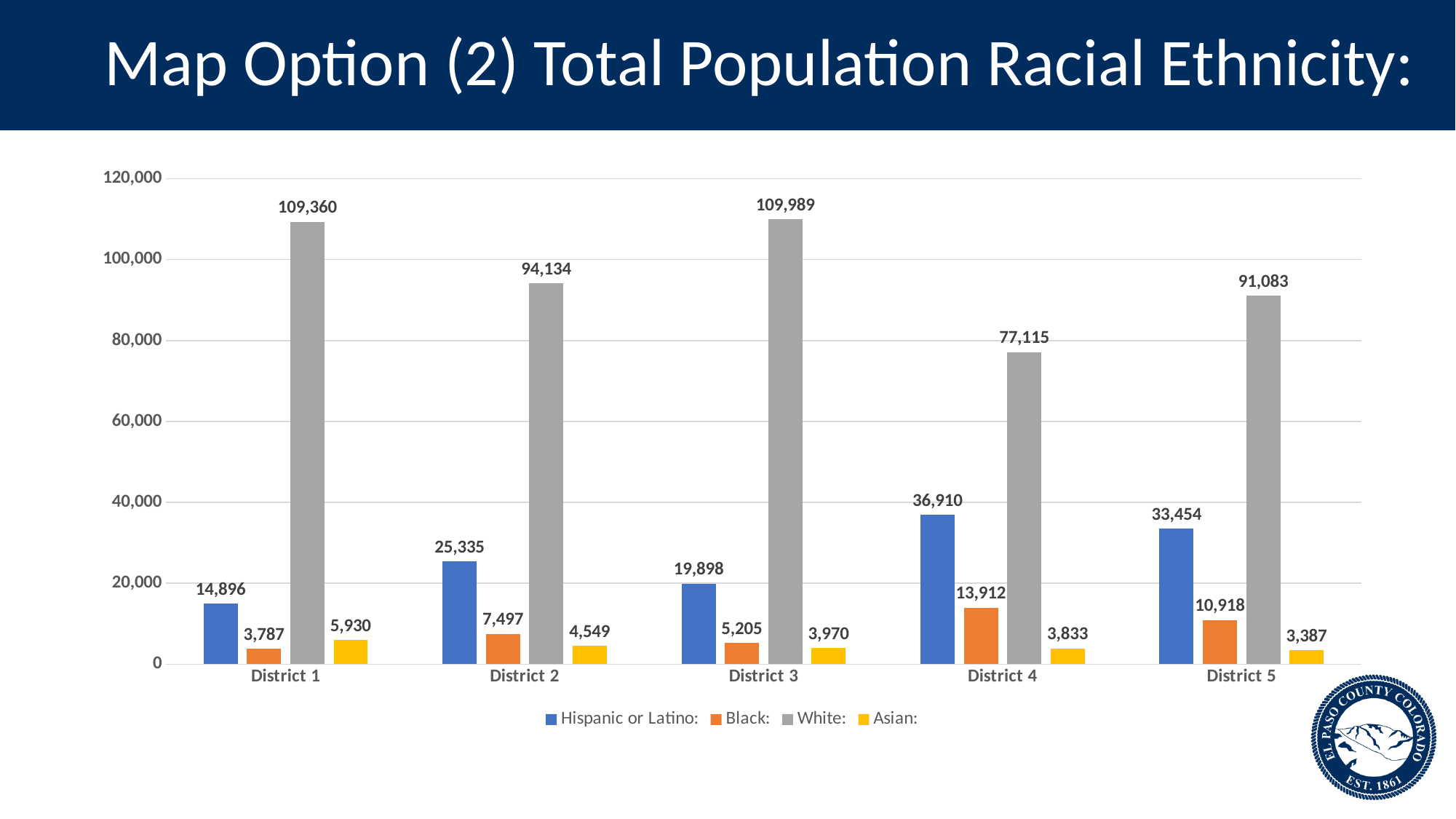
Is the White population value for District 4 greater or less than 80,000? less Which district has the highest White population? District 3 How many series does the legend list? 4 What is the Hispanic or Latino value for District 4? 36,910 Which is larger, the Black population in District 2 or in District 3? District 2 What is the Black population value for District 5? 10,918 What is the White population value for District 3? 109,989 How many districts are shown on the x axis? 5 What is the Asian population value for District 1? 5,930 What is the difference between the Hispanic or Latino values for District 4 and District 5? 3,456 What kind of chart is shown on the slide? Bar chart Which district has the lowest Asian population? District 5